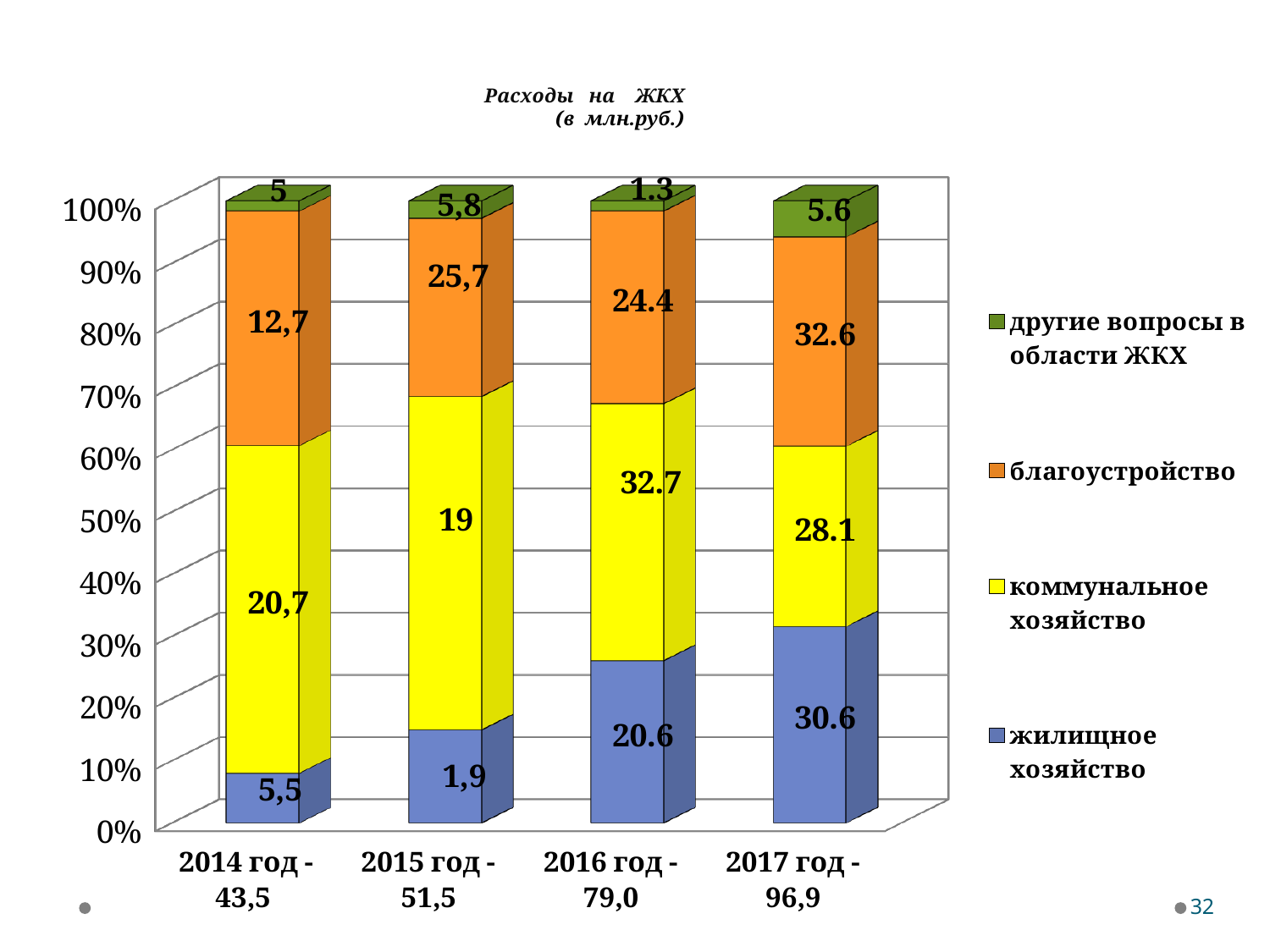
What is the difference between the благоустройство values for 2017 год and 2014 год? 19.9 What is the value of жилищное хозяйство for 2017 год? 30.6 How many series does the legend list? 4 Which year has the larger коммунальное хозяйство value, 2016 год or 2017 год? 2016 год What is the value of благоустройство for 2015 год? 25,7 What is the value of коммунальное хозяйство for 2016 год? 32.7 How many years are shown on the x axis? 4 In which year is the value of жилищное хозяйство the highest? 2017 год What kind of chart is shown on the slide? Stacked bar chart What total value is printed in the x-axis label for 2016 год? 79,0 In which year is the value of другие вопросы в области ЖКХ the lowest? 2016 год What is the value of другие вопросы в области ЖКХ for 2014 год? 5